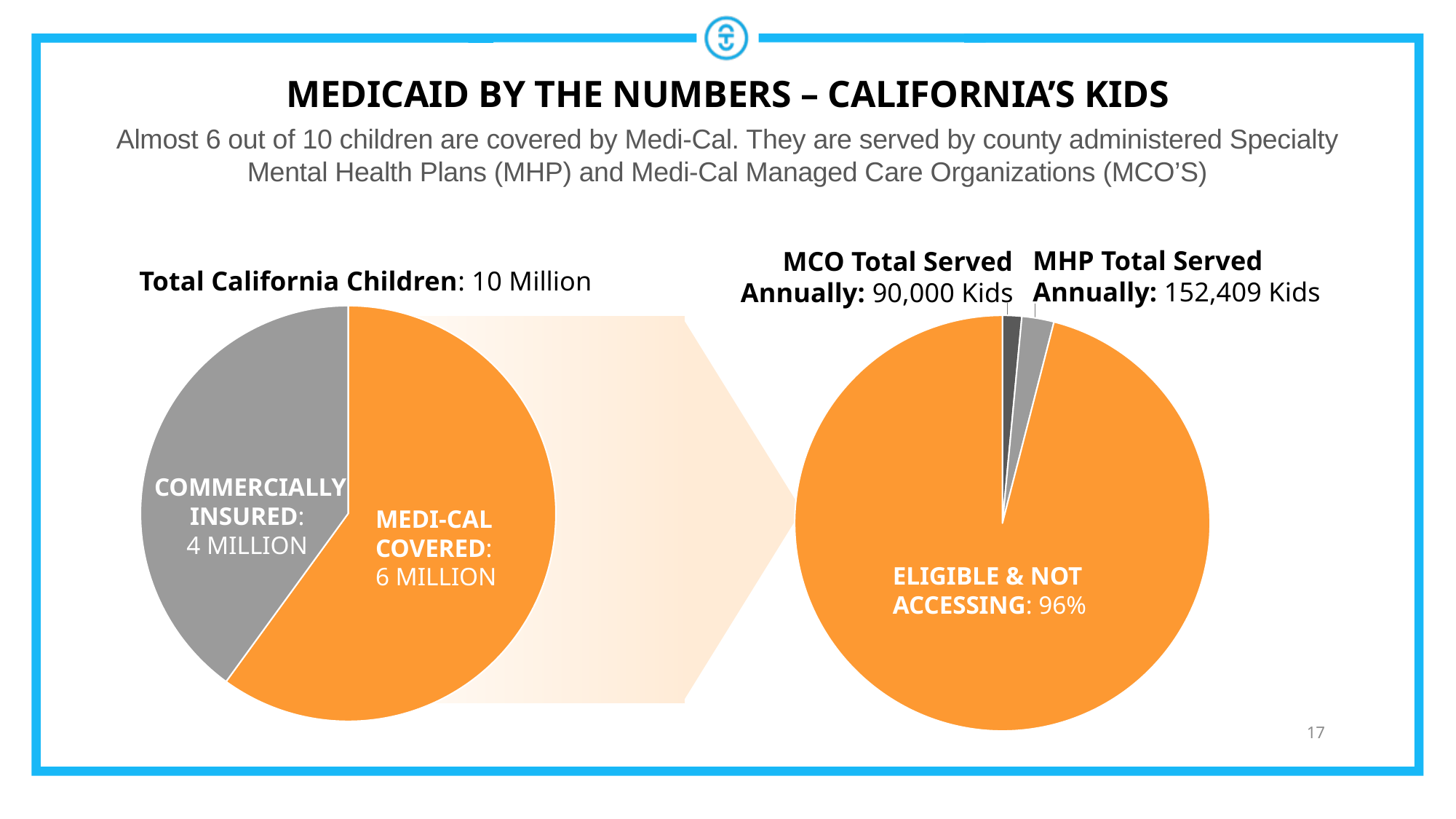
In the left pie chart, how many children are Medi-Cal covered? 6 MILLION What colour is the Commercially Insured slice in the left pie chart? Gray In the right pie chart, which is larger: MCO total served annually or MHP total served annually? MHP Total Served Annually In the left pie chart, which slice is larger: Commercially Insured or Medi-Cal Covered? Medi-Cal Covered In the right pie chart, how many kids does the MHP serve annually? 152,409 Kids In the left pie chart, what is the difference between the Medi-Cal covered and commercially insured children? 2 million What kind of chart is the left chart titled 'Total California Children: 10 Million'? Pie chart How many slices does the left pie chart have? 2 In the right pie chart, what percentage of children are eligible and not accessing? 96% In the right pie chart, how many kids does the MCO serve annually? 90,000 Kids In the left pie chart, how many children are commercially insured? 4 MILLION In the right pie chart, which slice is the largest? Eligible & Not Accessing